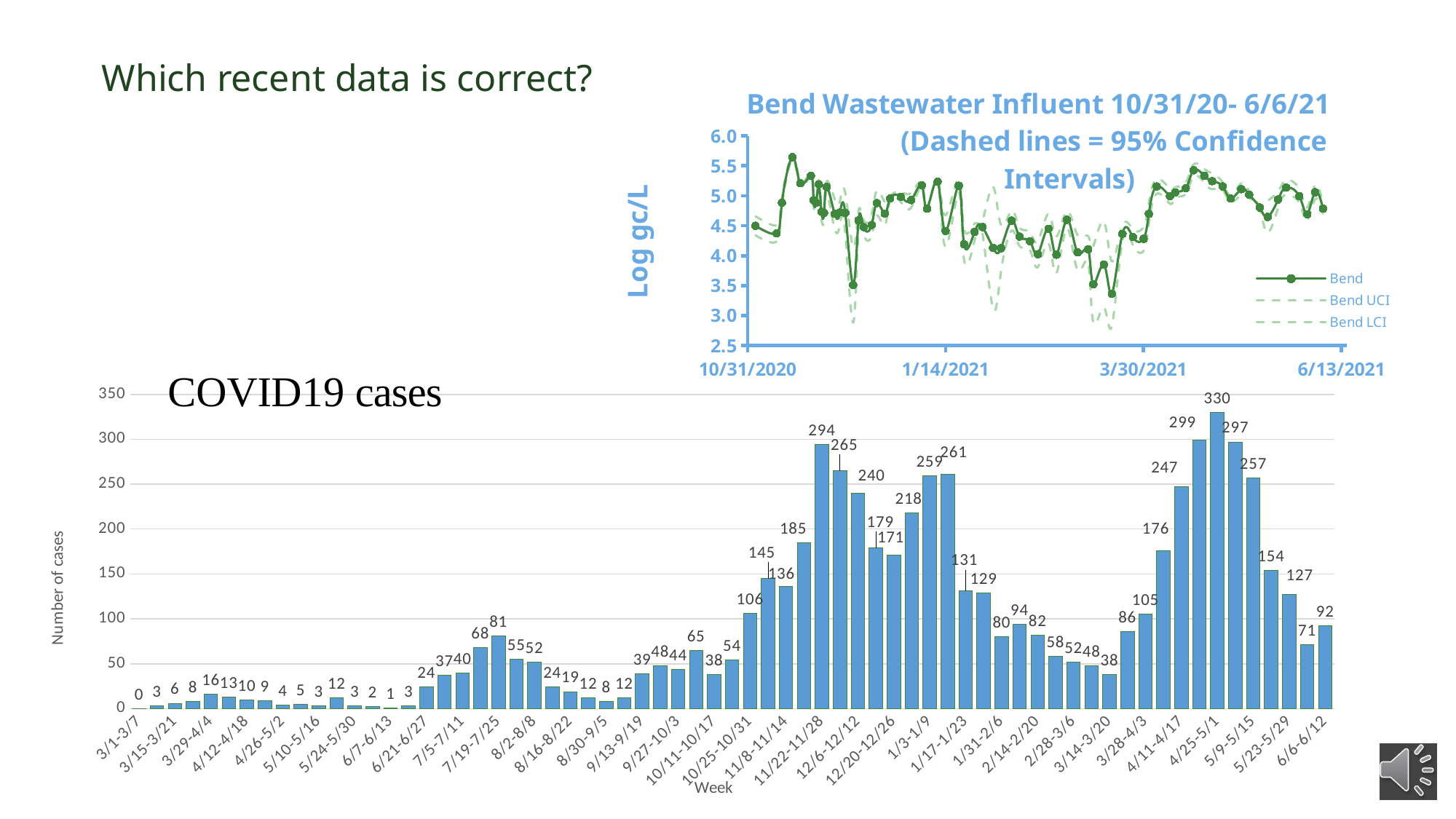
In the COVID19 cases chart, what is the difference between the highest bar (330) and the bar labelled 299? 31 In the COVID19 cases chart, what is the lowest number of cases shown for any week? 0 What kind of chart is the Bend Wastewater Influent chart at the top right? line chart In the COVID19 cases chart, how many cases are shown for the week 11/22-11/28? 294 In the Bend Wastewater Influent chart, is the first Bend value at 10/31/2020 greater or less than 5.0? less What is the y-axis label of the Bend Wastewater Influent chart? Log gc/L In the COVID19 cases chart, which week has the highest number of cases? 4/25-5/1 What kind of chart is the COVID19 cases chart at the bottom of the slide? bar chart In the COVID19 cases chart, which is larger: the bar labelled 294 or the bar labelled 259? 294 How many series does the legend of the Bend Wastewater Influent chart list? 3 In the COVID19 cases chart, how many cases are shown for the week 6/6-6/12? 92 In the COVID19 cases chart, what is the highest number of cases shown for any week? 330